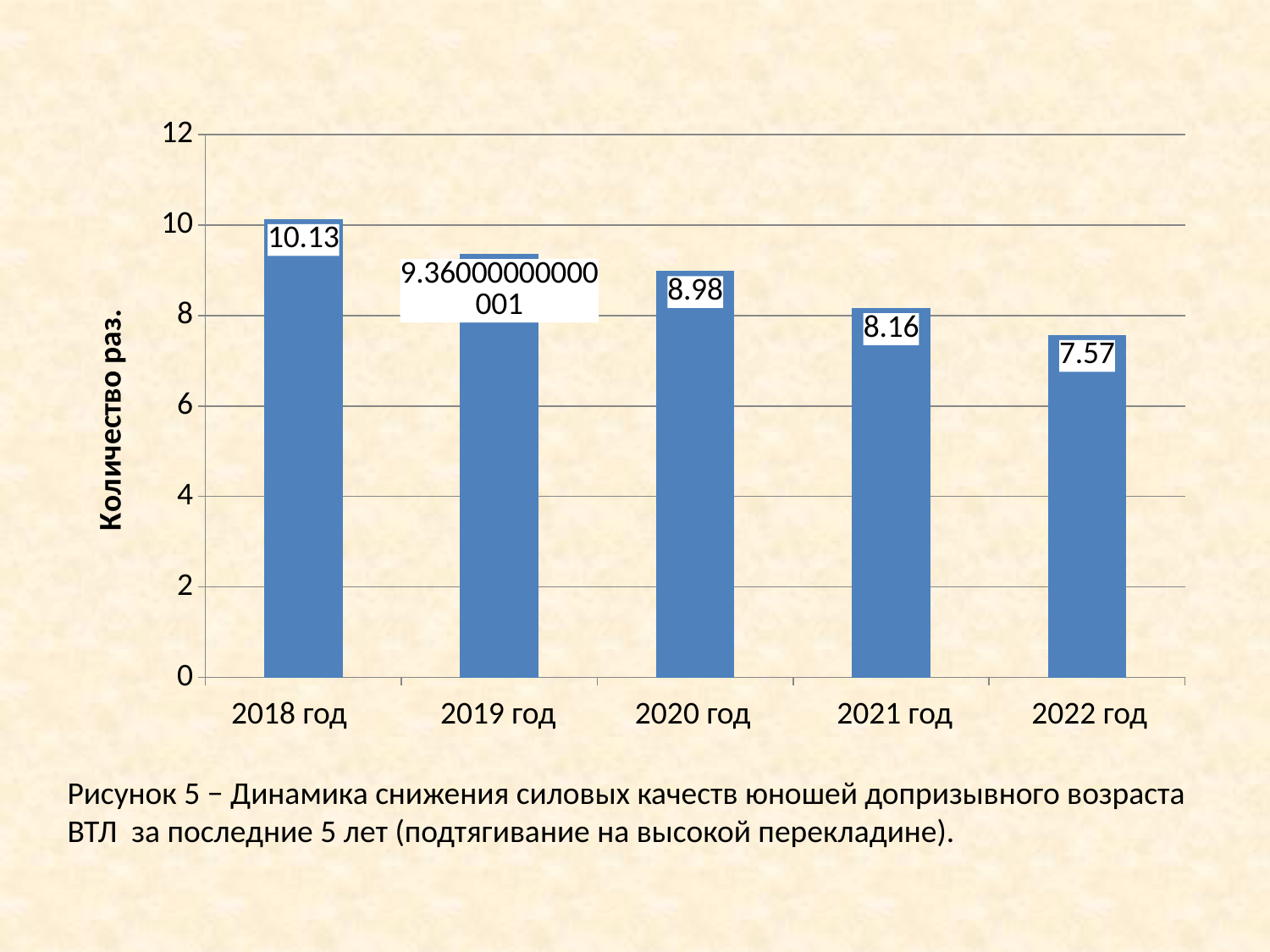
What is the difference between the values for 2018 год and 2022 год? 2.56 Is the value for 2019 год greater or less than 8? greater How many years are shown on the x axis? 5 Which year has the highest value? 2018 год What is the value for 2022 год? 7.57 Which is larger, the value for 2020 год or 2021 год? 2020 год What is the value for 2018 год? 10.13 Do the values rise or fall from 2018 год to 2022 год? fall Which year has the lowest value? 2022 год What kind of chart is shown on the slide? bar chart What is the value for 2021 год? 8.16 What is the value for 2020 год? 8.98